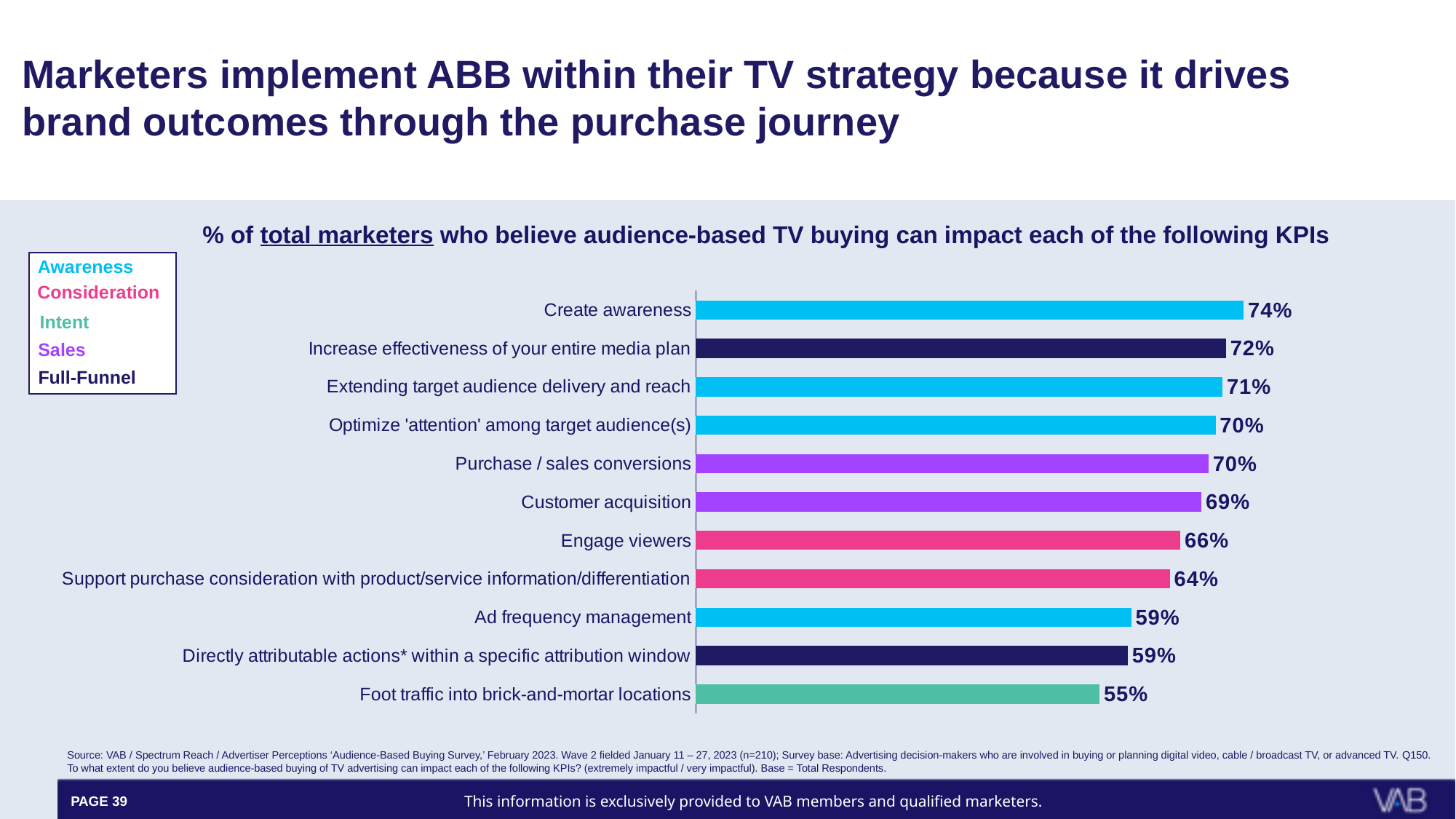
What percentage of total marketers believe audience-based TV buying can impact 'Create awareness'? 74% Which KPI has the lowest percentage? Foot traffic into brick-and-mortar locations What is the value for 'Customer acquisition'? 69% Which KPI has the highest percentage? Create awareness Which is larger: the value for 'Increase effectiveness of your entire media plan' or the value for 'Engage viewers'? Increase effectiveness of your entire media plan How many categories does the legend list? 5 What is the difference between the values for 'Create awareness' and 'Foot traffic into brick-and-mortar locations'? 19% Which legend category is shown in green? Intent How many KPIs are shown in the chart? 11 What is the value for 'Foot traffic into brick-and-mortar locations'? 55% What kind of chart is shown on the slide? Bar chart What is the value for 'Engage viewers'? 66%